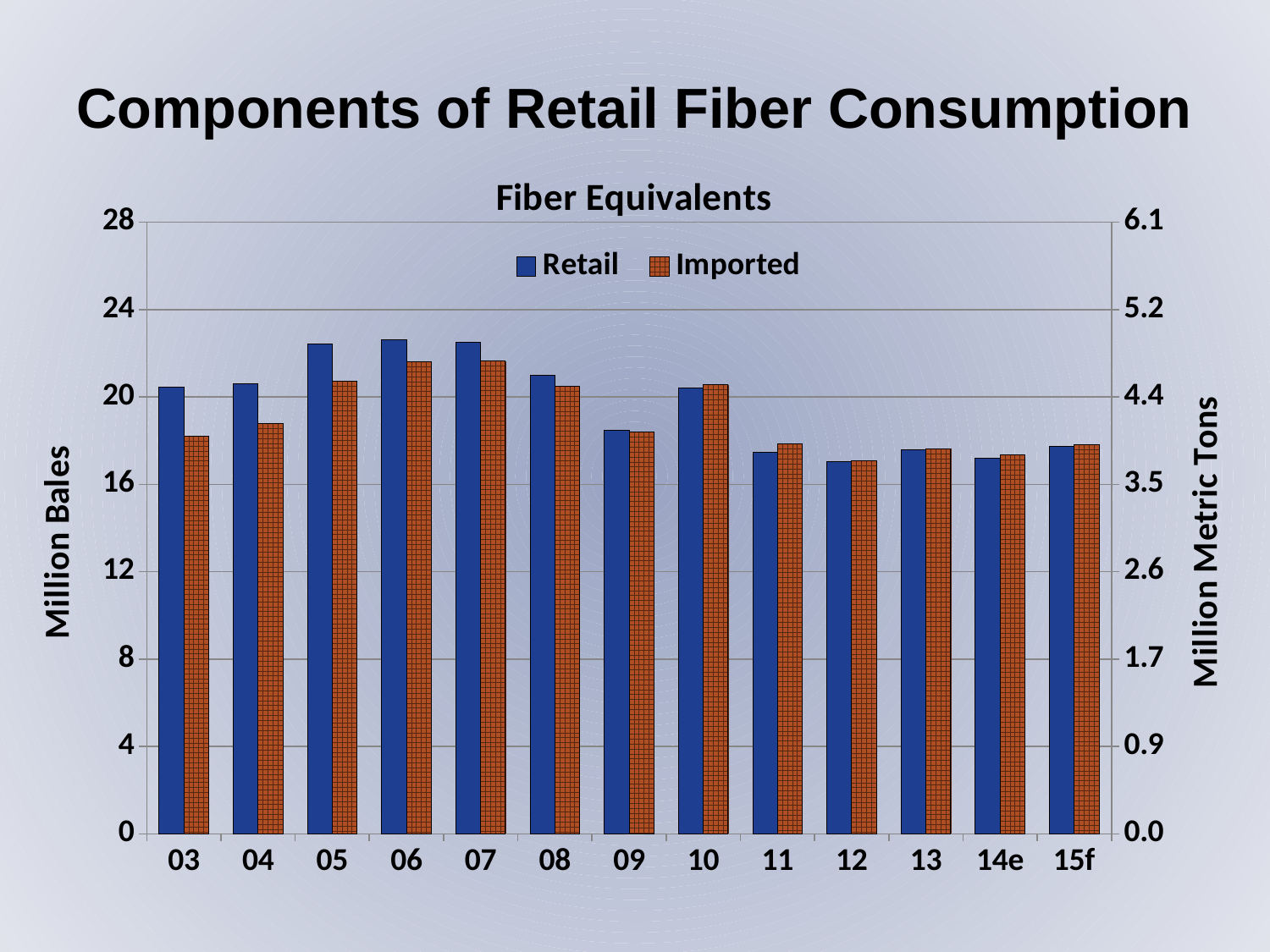
What is the title shown above the chart's legend? Fiber Equivalents Is the Retail value for 05 greater or less than 20 million bales? greater Is the Retail value for 06 greater or less than 24 million bales? less Is the Imported value for 03 greater or less than 20 million bales? less Do the Retail values rise or fall from 07 to 09? fall How many series does the legend list? 2 In 03, which is larger, the Retail value or the Imported value? Retail How many years are shown along the x axis? 13 What kind of chart is shown on the slide? bar chart What is the label on the right-hand vertical axis? Million Metric Tons In 05, which is larger, the Retail value or the Imported value? Retail